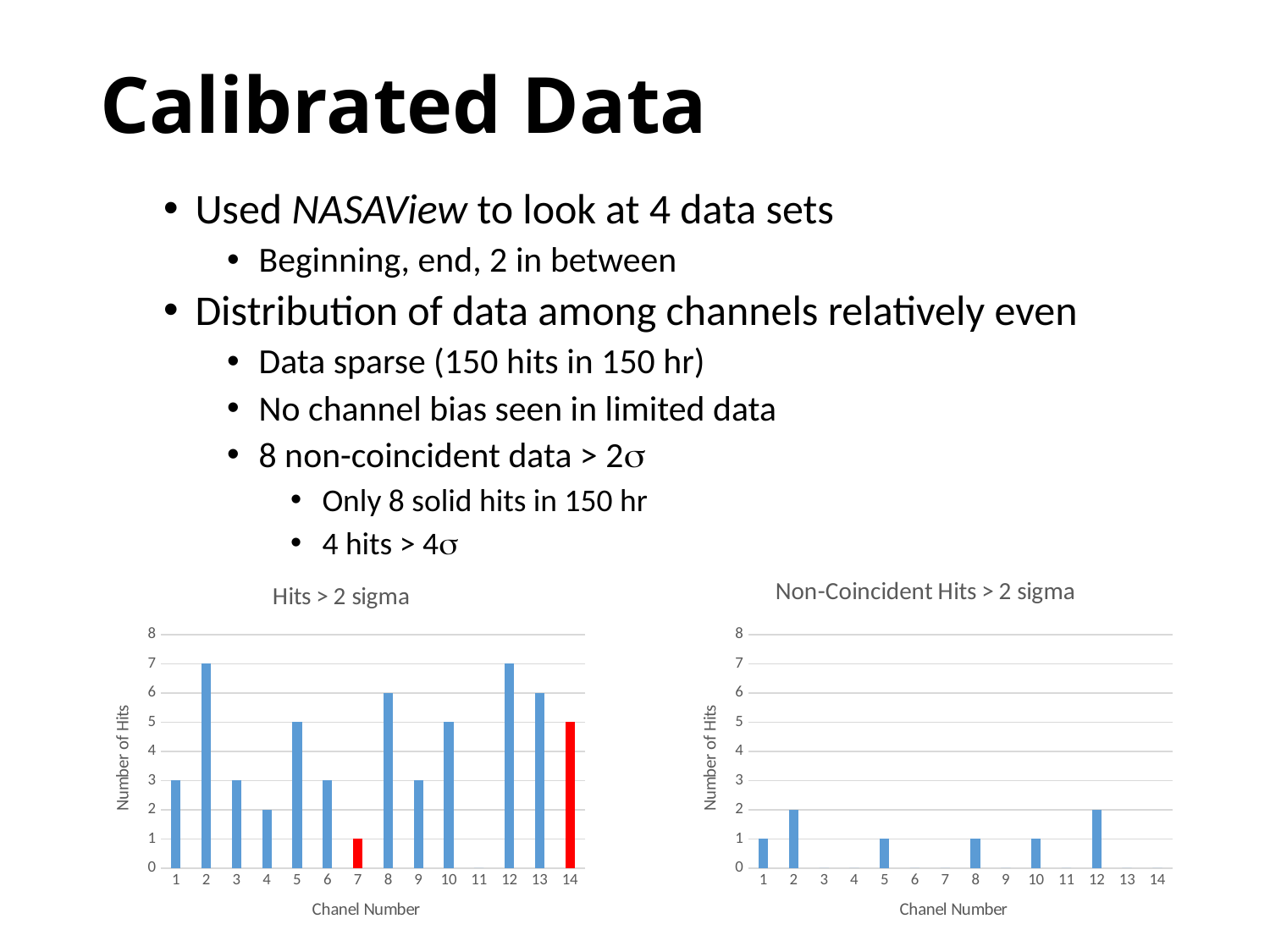
In the 'Non-Coincident Hits > 2 sigma' chart, how many hits does channel 5 have? 1 How many channel numbers are shown on the x axis of the 'Non-Coincident Hits > 2 sigma' chart? 14 In the 'Hits > 2 sigma' chart, which channels have red bars? Channels 7 and 14 In the 'Hits > 2 sigma' chart, which has more hits, channel 13 or channel 9? Channel 13 What kind of chart is the 'Hits > 2 sigma' chart? Bar chart In the 'Hits > 2 sigma' chart, how many hits does channel 7 have? 1 In the 'Non-Coincident Hits > 2 sigma' chart, which has more hits, channel 2 or channel 10? Channel 2 In the 'Hits > 2 sigma' chart, is the value for channel 12 greater or less than 4? greater In the 'Non-Coincident Hits > 2 sigma' chart, how many hits does channel 12 have? 2 In the 'Hits > 2 sigma' chart, how many hits does channel 14 have? 5 In the 'Hits > 2 sigma' chart, how many hits does channel 2 have? 7 In the 'Hits > 2 sigma' chart, what is the difference in hits between channel 8 and channel 4? 4